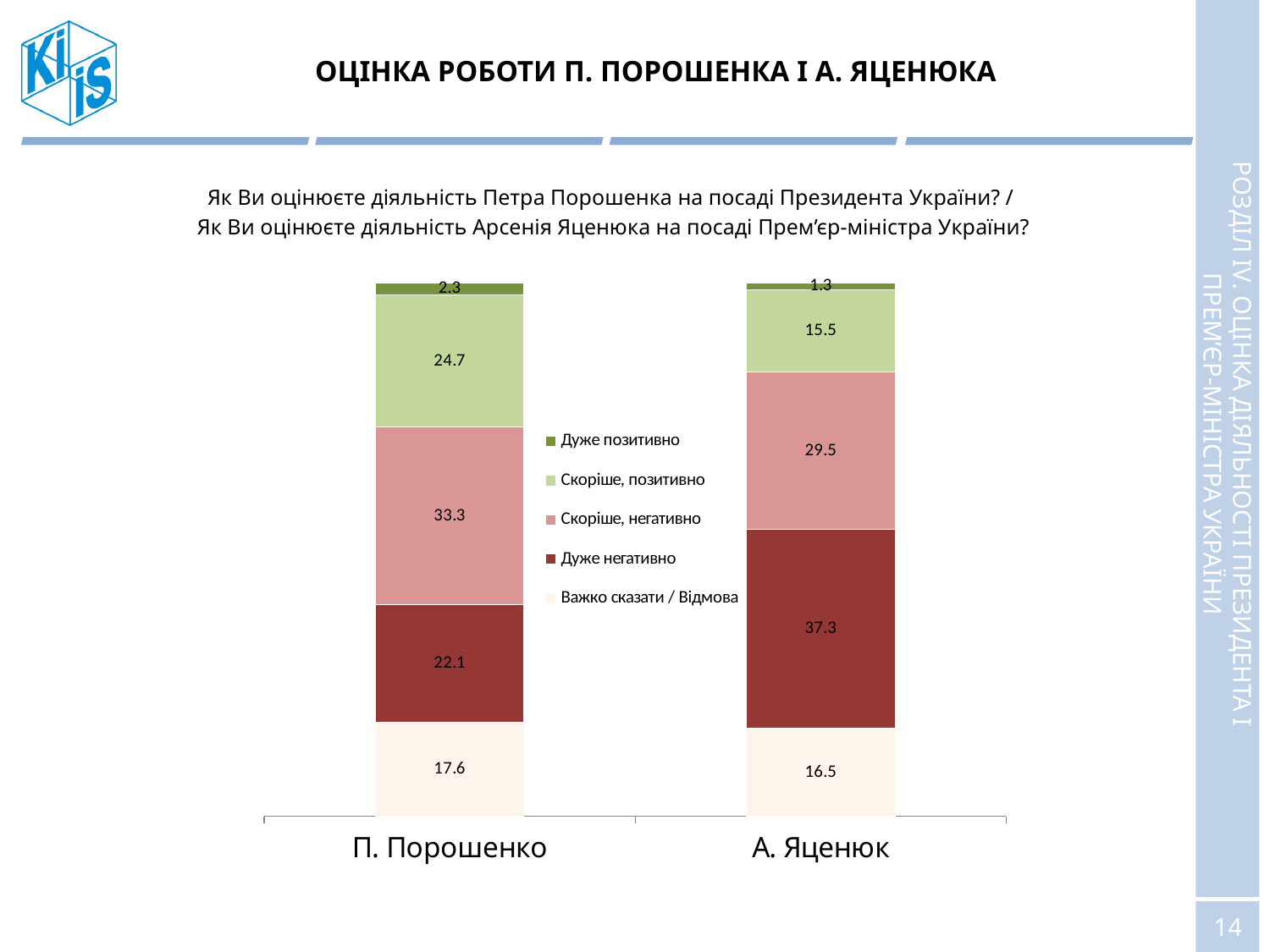
What is the difference between the "Скоріше, позитивно" values for П. Порошенко and А. Яценюк? 9.2 How many categories (bars) are shown on the x axis? 2 What is the value for "Дуже негативно" for А. Яценюк? 37.3 What is the value for "Важко сказати / Відмова" for П. Порошенко? 17.6 What kind of chart is shown on the slide? Stacked bar chart Which series has the largest value in the П. Порошенко bar? Скоріше, негативно What is the value for "Скоріше, негативно" for П. Порошенко? 33.3 How many series does the legend list? 5 What is the difference between the "Дуже негативно" values for А. Яценюк and П. Порошенко? 15.2 Which category has the higher value for "Дуже негативно", П. Порошенко or А. Яценюк? А. Яценюк Which series has the smallest value in the А. Яценюк bar? Дуже позитивно What is the value for "Скоріше, позитивно" for А. Яценюк? 15.5